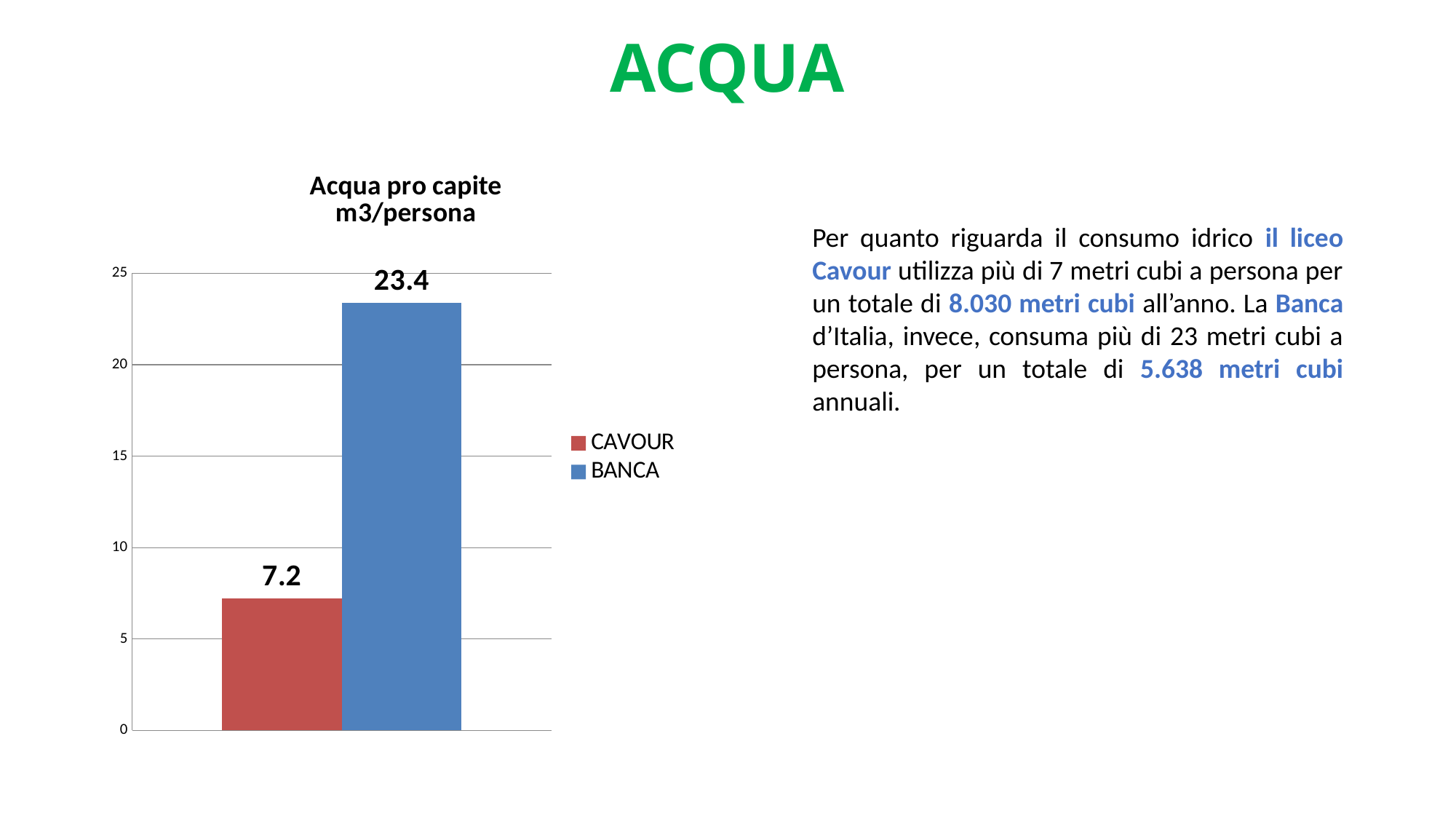
What is the title of the chart? Acqua pro capite m3/persona Which series has the highest value in the chart? BANCA What is the difference between the BANCA value and the CAVOUR value? 16.2 How many series does the legend list? 2 Is the value for BANCA greater or less than 20? greater How many bars are plotted in the chart? 2 Which series has the lowest value in the chart? CAVOUR Is the value for CAVOUR greater or less than 10? less What is the value for BANCA in the chart? 23.4 Which is larger, the value for CAVOUR or the value for BANCA? BANCA What is the value for CAVOUR in the chart? 7.2 What kind of chart is shown on the slide? bar chart